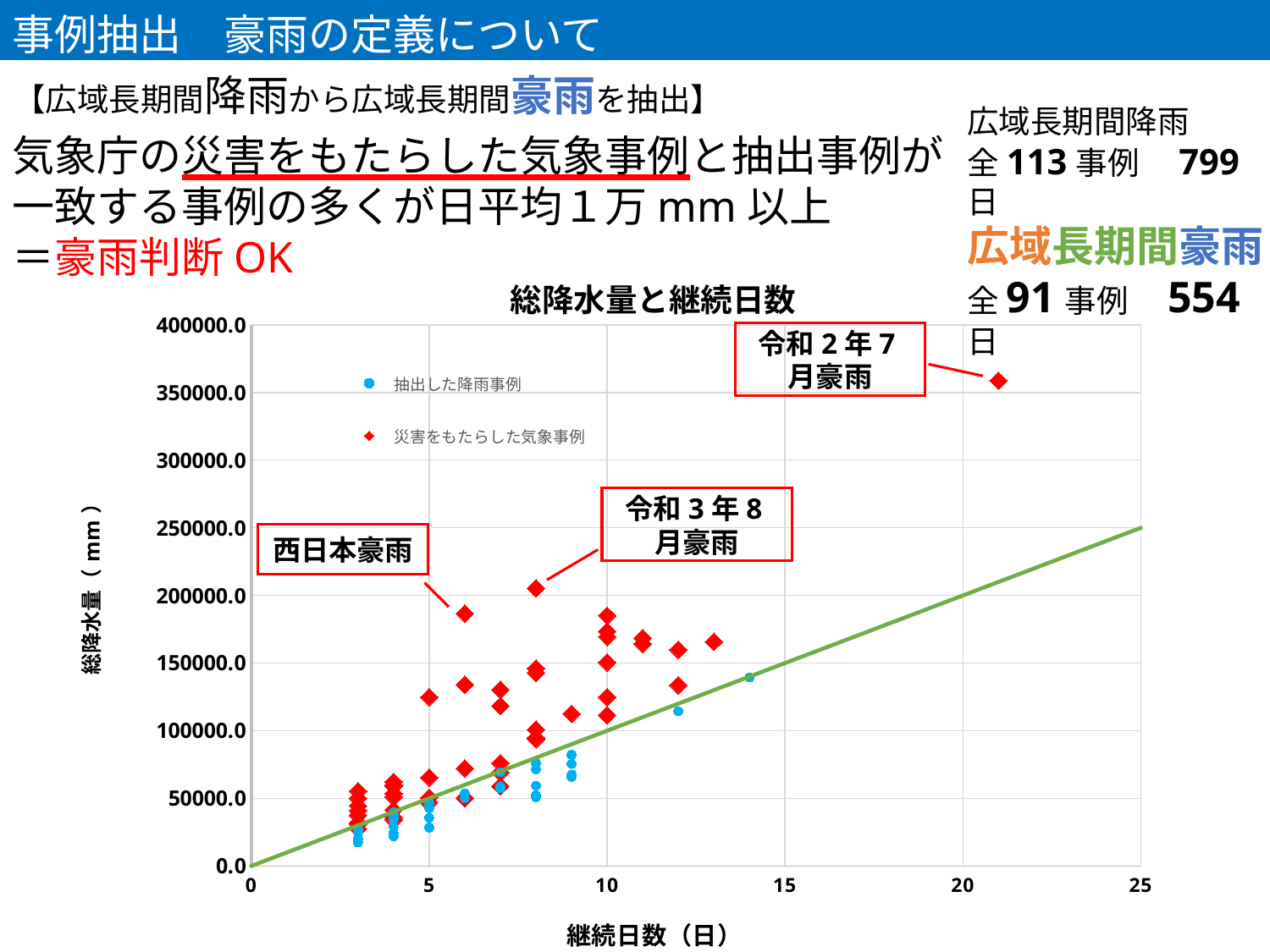
Is the total precipitation for 令和3年8月豪雨 greater or less than 150000.0? greater Which has the higher total precipitation, 令和3年8月豪雨 or 西日本豪雨? 令和3年8月豪雨 How many series does the chart's legend list? 2 Is the duration (継続日数) for 令和2年7月豪雨 greater or less than 20 days? greater Which has the higher total precipitation, 令和2年7月豪雨 or 令和3年8月豪雨? 令和2年7月豪雨 What kind of chart is shown on the slide? scatter chart Is the total precipitation for 西日本豪雨 greater or less than 200000.0? less Which series is plotted with red diamond markers? 災害をもたらした気象事例 Of the three labelled events on the chart, which has the highest total precipitation? 令和2年7月豪雨 What is the title of the chart? 総降水量と継続日数